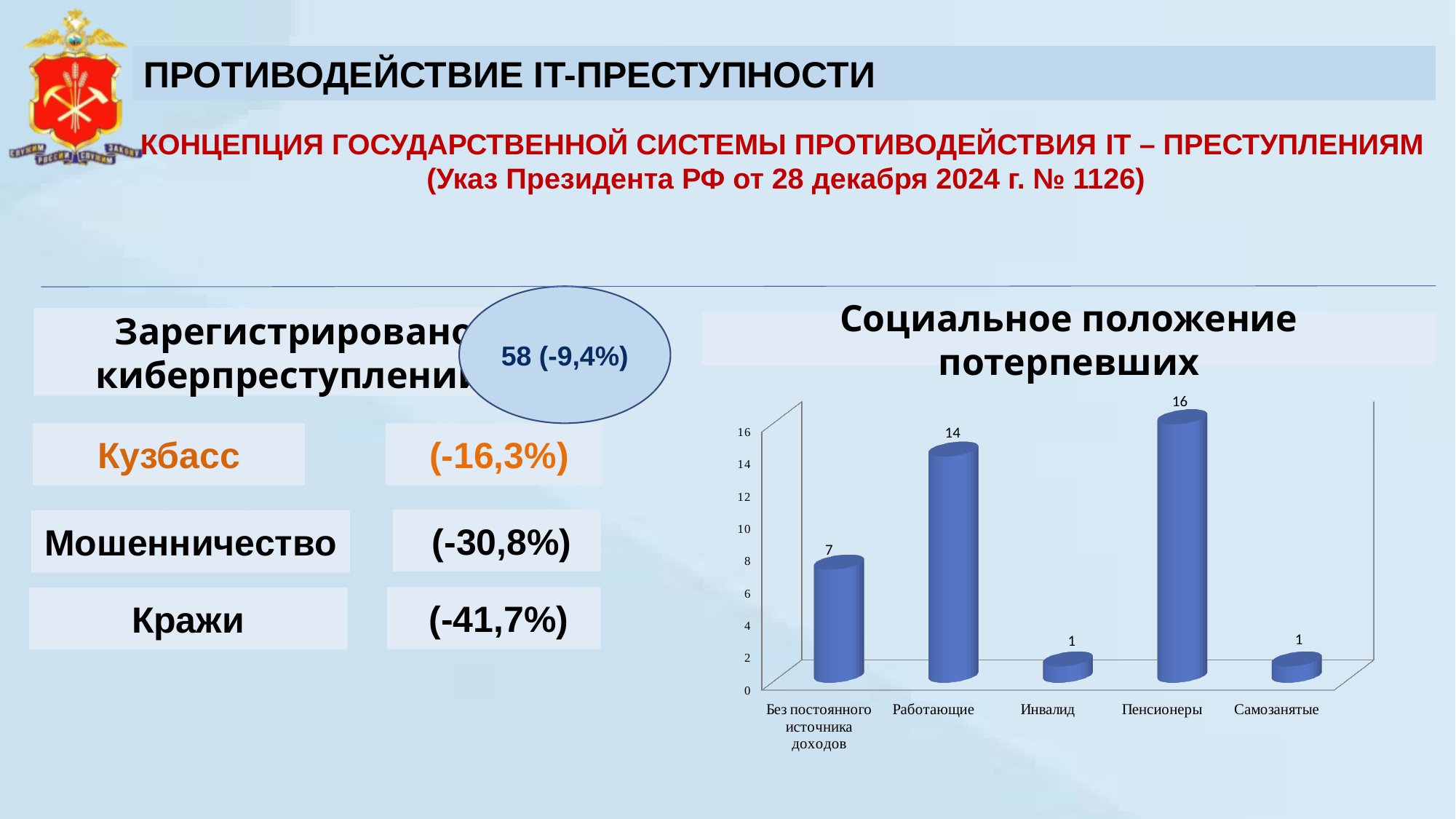
What is the value for Самозанятые in the chart? 1 What kind of chart is 'Социальное положение потерпевших'? Bar chart What is the difference between the values for Пенсионеры and Работающие? 2 What is the difference between the values for Работающие and 'Без постоянного источника доходов'? 7 What is the value for Работающие in the chart? 14 Which category has the highest value in the chart 'Социальное положение потерпевших'? Пенсионеры How many categories are shown in the chart 'Социальное положение потерпевших'? 5 Is the value for Пенсионеры greater or less than 10? greater What is the value for 'Без постоянного источника доходов' in the chart? 7 What is the value for Пенсионеры in the chart 'Социальное положение потерпевших'? 16 What is the title of the chart on the right side of the slide? Социальное положение потерпевших Which is larger, the value for Работающие or the value for 'Без постоянного источника доходов'? Работающие